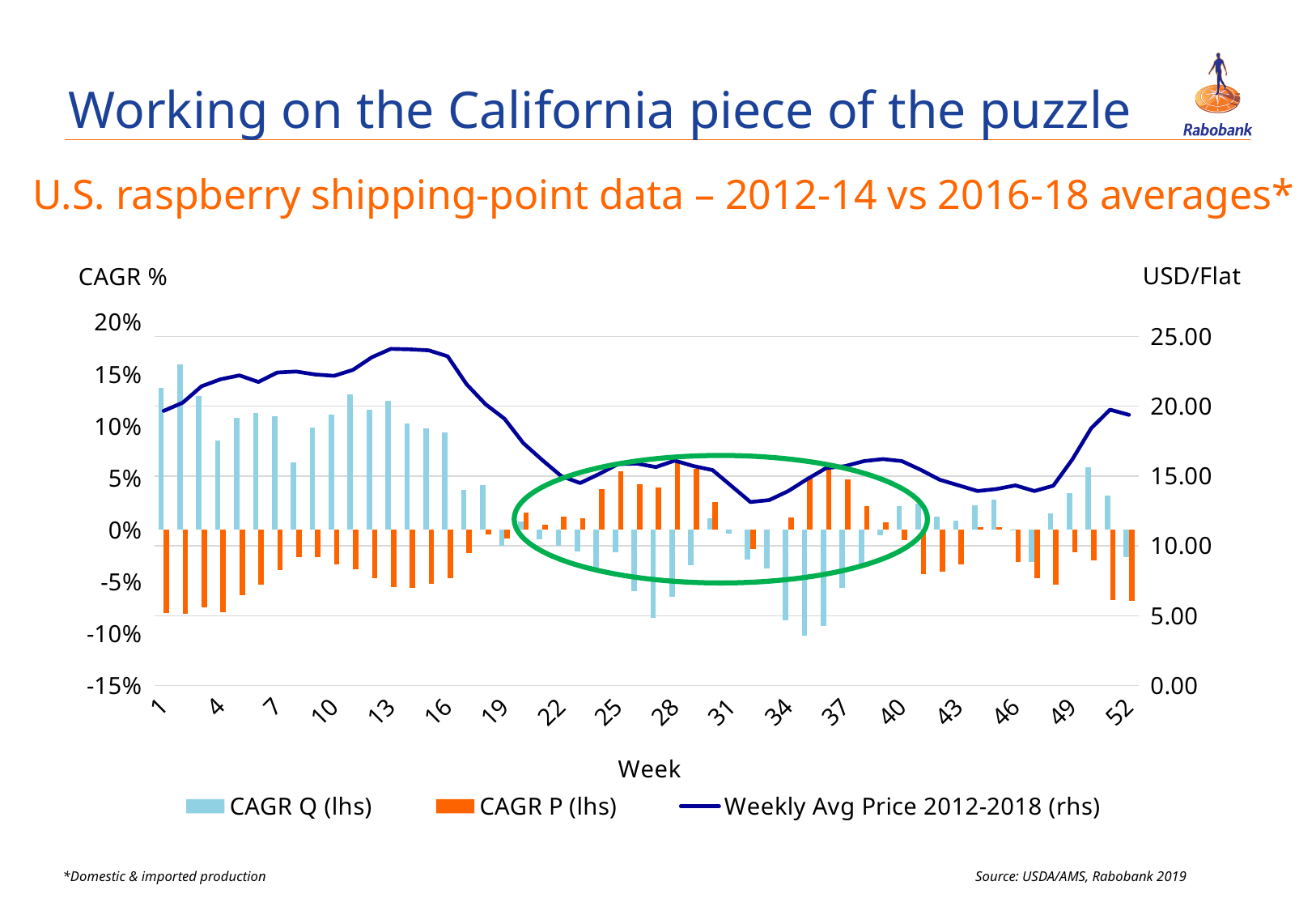
Is the CAGR P value for week 1 greater or less than -5%? less Does the Weekly Avg Price 2012-2018 line rise or fall between week 46 and week 51? Rise Is the CAGR Q value for week 1 greater or less than 10%? greater Which is larger, the CAGR Q value for week 1 or for week 52? Week 1 Is the Weekly Avg Price 2012-2018 for week 13 greater or less than 20.00 USD/Flat? greater Does the Weekly Avg Price 2012-2018 line rise or fall between week 16 and week 22? Fall What unit is shown on the right-hand axis of the chart? USD/Flat How many series does the legend list? 3 Which is larger, the Weekly Avg Price 2012-2018 at week 13 or at week 31? Week 13 What kind of chart is shown on the slide? A combined bar and line chart How many weeks are plotted along the x axis? 52